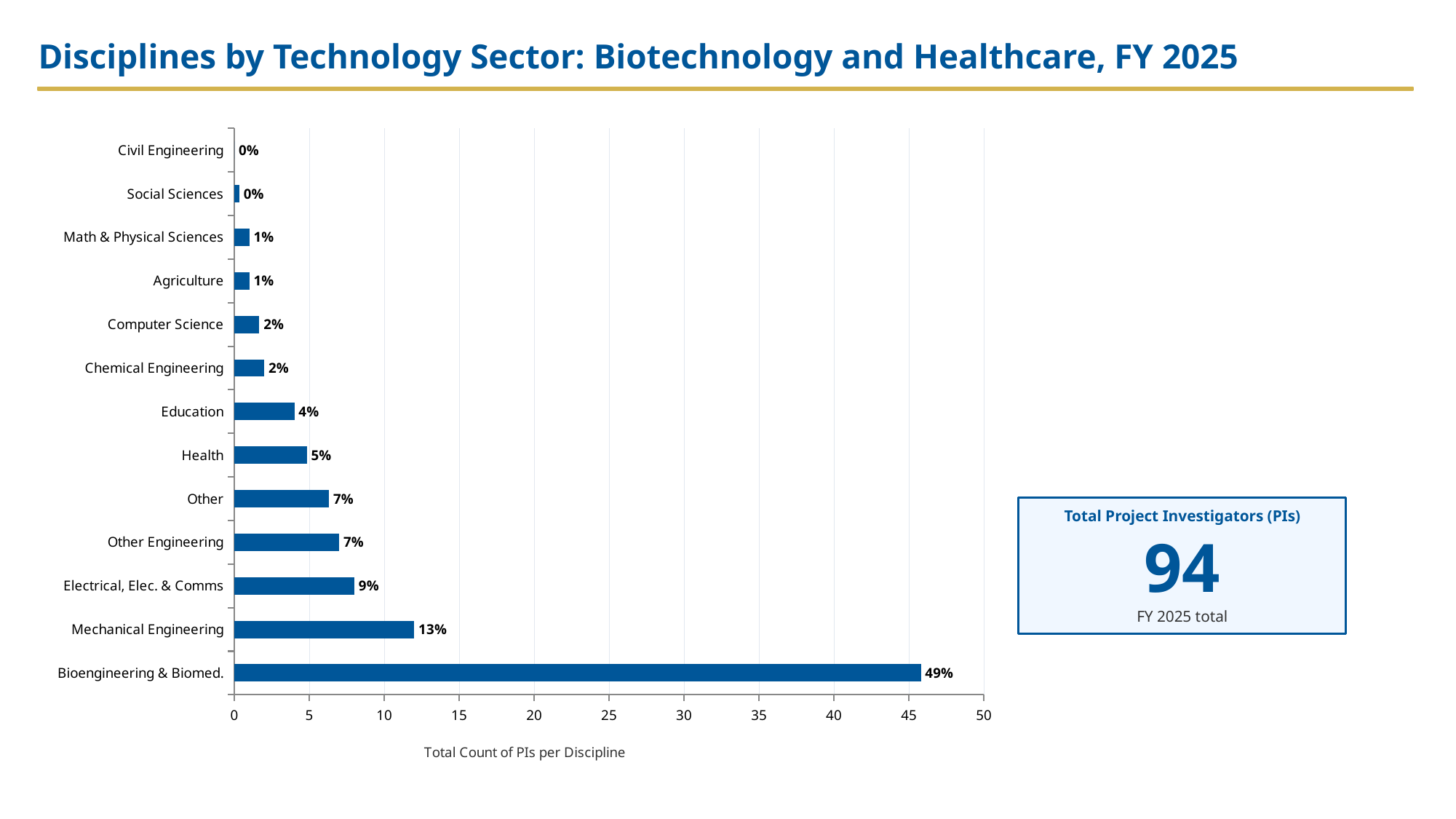
What data label is shown for Health? 5% How many disciplines are listed on the chart? 13 Is the count of PIs for Bioengineering & Biomed. greater or less than 40? greater What data label is shown for Bioengineering & Biomed.? 49% What is the difference between the percentage labels for Bioengineering & Biomed. and Mechanical Engineering? 36% Which discipline has the highest count of PIs? Bioengineering & Biomed. What data label is shown for Mechanical Engineering? 13% Which has a larger count of PIs, Education or Electrical, Elec. & Comms? Electrical, Elec. & Comms What is the total number of Project Investigators shown in the box on the slide? 94 What kind of chart is shown on the slide? bar chart Which discipline has the lowest count of PIs? Civil Engineering What data label is shown for Electrical, Elec. & Comms? 9%